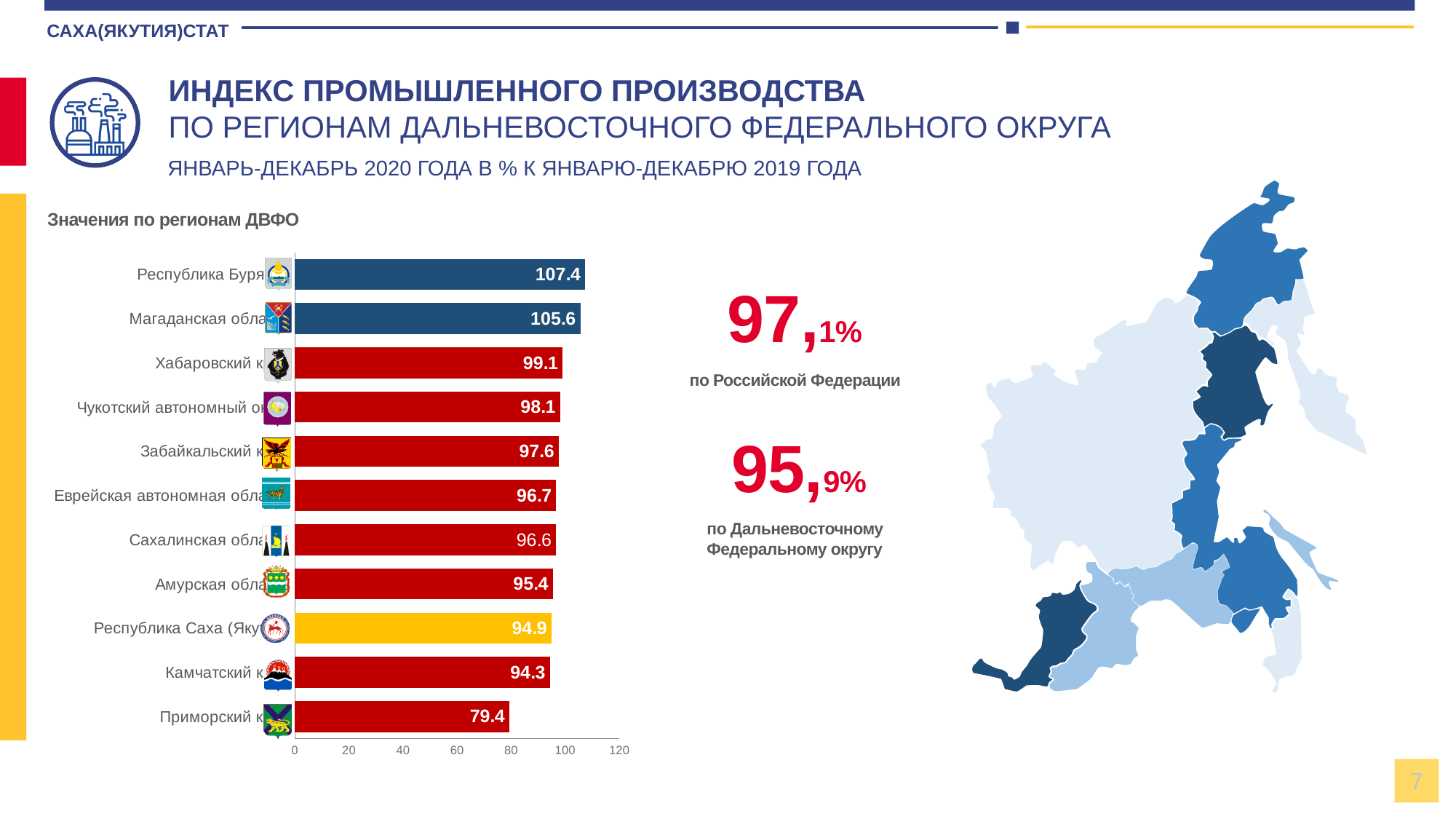
What colour is the bar for Республика Саха (Якутия)? Yellow What is the value for Республика Бурятия? 107.4 What kind of chart is shown on the slide? Bar chart Which region has the highest value? Республика Бурятия What is the difference between the values for Хабаровский край and Приморский край? 19.7 What is the value for Республика Саха (Якутия)? 94.9 How many regions are shown in the bar chart? 11 What is the value for Приморский край? 79.4 What is the difference between the values for Республика Бурятия and Магаданская область? 1.8 What is the value for Чукотский автономный округ? 98.1 Which region has the lowest value? Приморский край Which is larger, the value for Амурская область or the value for Камчатский край? Амурская область